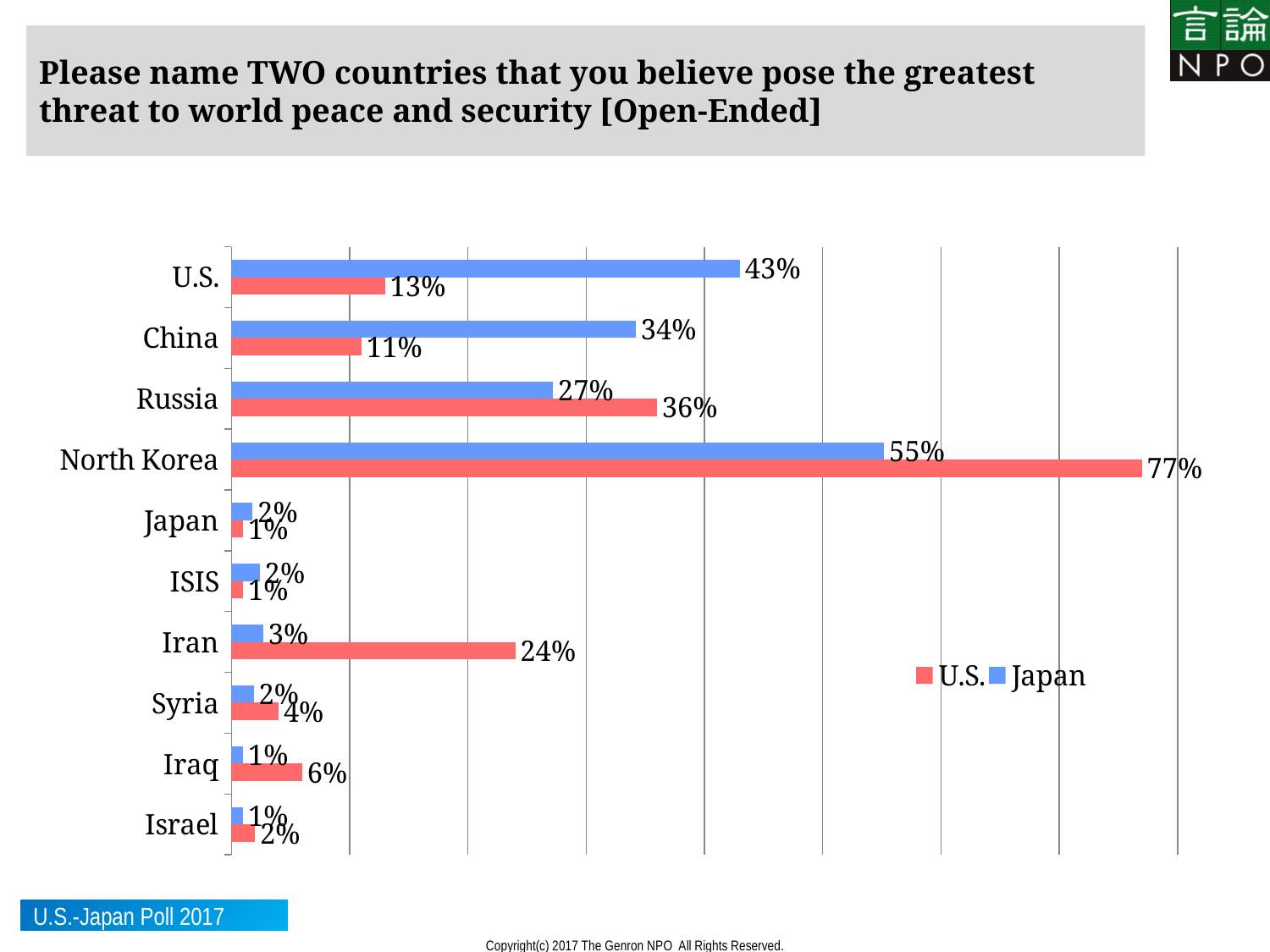
Which colour represents the U.S. series in the legend? red What is the difference between the Japan and U.S. values for China? 23% For Russia, which series has the larger value, U.S. or Japan? U.S. What kind of chart is shown on the slide? bar chart What percentage of U.S. respondents named North Korea? 77% Which country received the highest percentage from U.S. respondents? North Korea What percentage of U.S. respondents named Iran? 24% How many series does the legend list? 2 How many countries or groups are listed on the chart? 10 What is the difference between the U.S. and Japan values for North Korea? 22% What percentage of Japanese respondents named the U.S.? 43% Which country received the highest percentage from Japanese respondents? North Korea